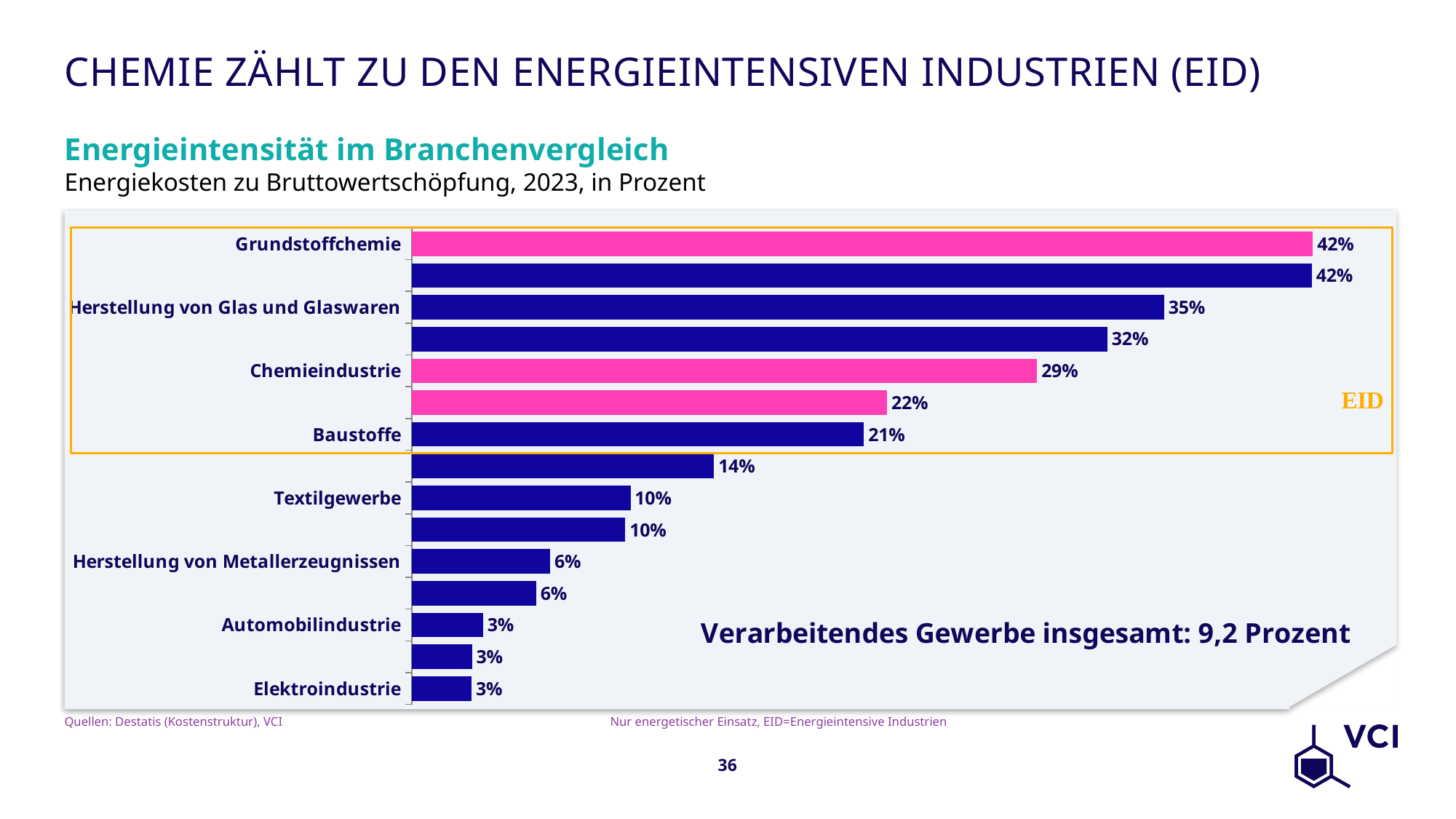
What is the value for Chemieindustrie? 29% What is the value for Herstellung von Glas und Glaswaren? 35% What is the value for Textilgewerbe? 10% What is the value for Grundstoffchemie? 42% Which has the larger value, Chemieindustrie or Textilgewerbe? Chemieindustrie What is the title of the chart? Energieintensität im Branchenvergleich What value is given for Verarbeitendes Gewerbe insgesamt in the chart annotation? 9,2 Prozent What is the value for Baustoffe? 21% How many bars are plotted in the chart? 15 What is the difference in percentage points between Grundstoffchemie and Chemieindustrie? 13 What kind of chart is shown on the slide? Bar chart What is the value for Herstellung von Metallerzeugnissen? 6%